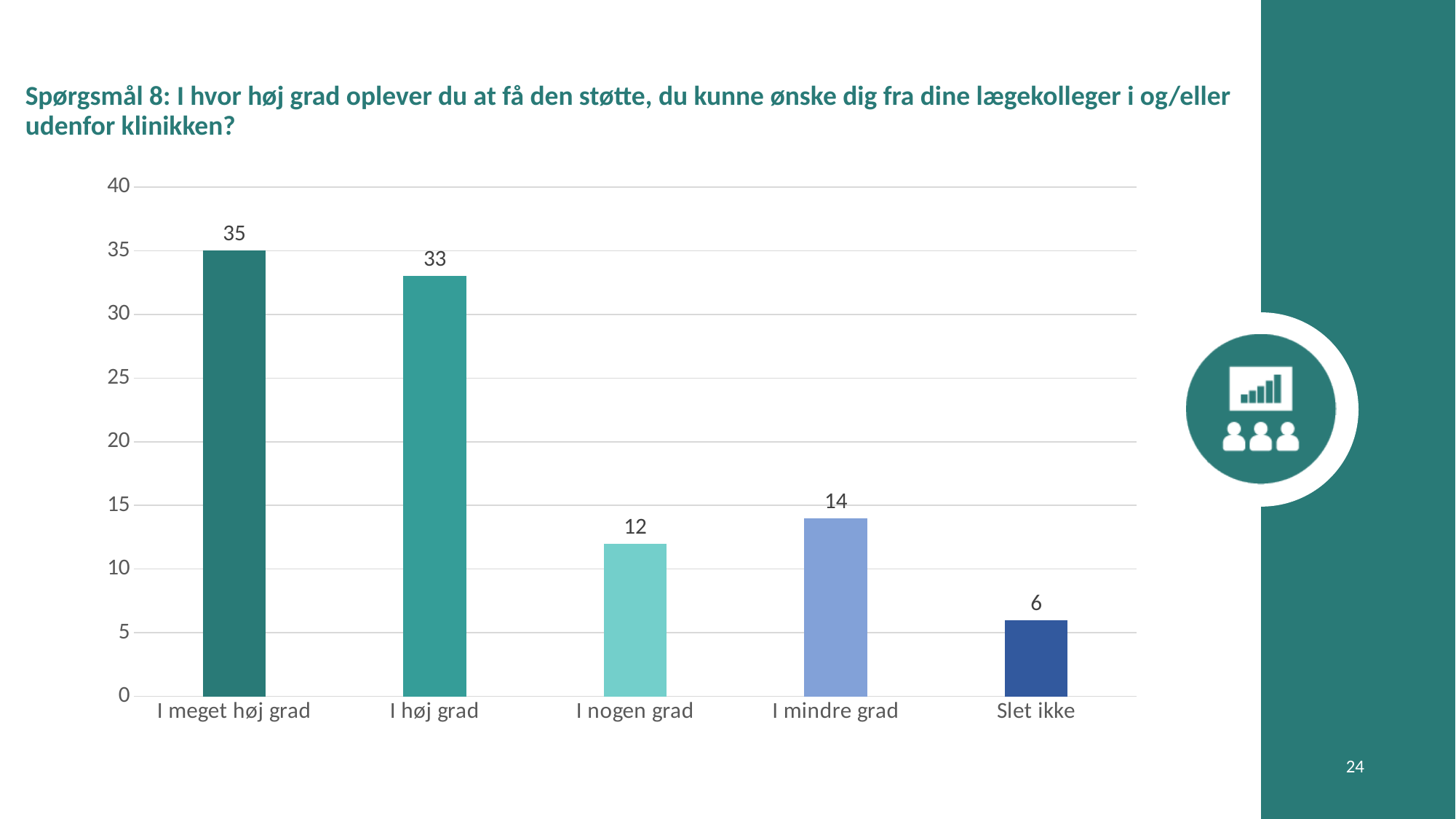
What is the value for "I meget høj grad"? 35 What is the highest value shown on the y axis? 40 Which is larger, the value for "I nogen grad" or the value for "I mindre grad"? I mindre grad What is the value for "Slet ikke"? 6 Is the value for "I høj grad" greater or less than 30? greater Which category has the highest value? I meget høj grad What is the difference between the values for "I meget høj grad" and "I høj grad"? 2 What is the difference between the values for "I mindre grad" and "Slet ikke"? 8 What is the value for "I nogen grad"? 12 What kind of chart is shown on the slide? bar chart Which category has the lowest value? Slet ikke How many categories are shown on the x axis? 5